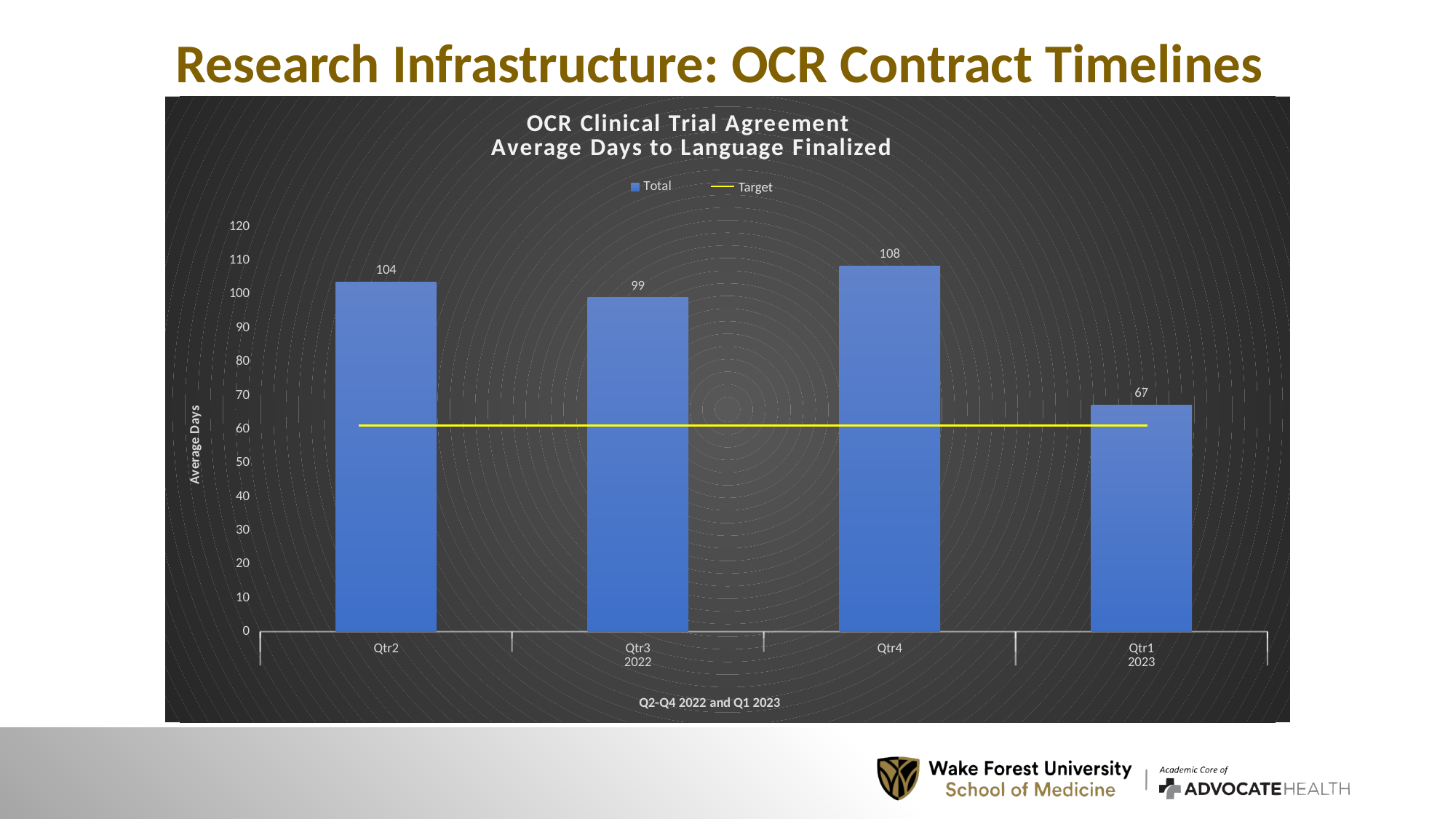
What is the value for Qtr2 2022? 104 What is the value for Qtr3 2022? 99 How many quarters are shown on the x axis? 4 What kind of chart is shown? bar chart Is the Target line greater or less than 70? less Which quarter has the highest average days to language finalized? Qtr4 2022 What is the value for Qtr4 2022? 108 How many series does the legend list? 2 Which is larger, the value for Qtr2 2022 or Qtr3 2022? Qtr2 2022 Which quarter has the lowest average days to language finalized? Qtr1 2023 What is the difference between the values for Qtr4 2022 and Qtr1 2023? 41 What is the value for Qtr1 2023? 67